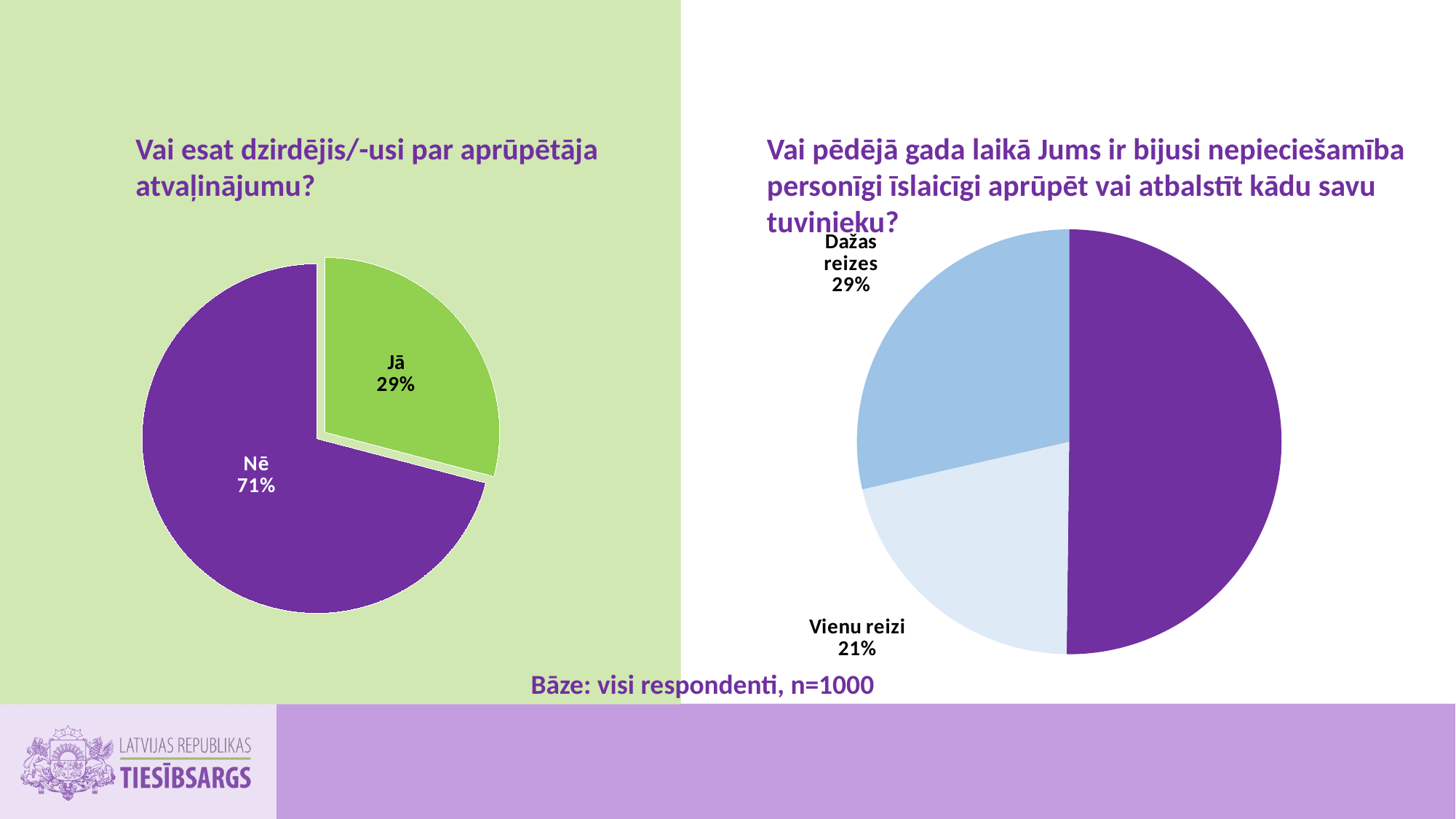
In the left chart ("Vai esat dzirdējis/-usi par aprūpētāja atvaļinājumu?"), what share of respondents answered "Jā"? 29% In the left chart ("Vai esat dzirdējis/-usi par aprūpētāja atvaļinājumu?"), what is the difference in percentage points between "Nē" and "Jā"? 42 percentage points How many slices does the right pie chart ("Vai pēdējā gada laikā Jums ir bijusi nepieciešamība personīgi īslaicīgi aprūpēt vai atbalstīt kādu savu tuvinieku?") have? 3 How many slices does the left pie chart ("Vai esat dzirdējis/-usi par aprūpētāja atvaļinājumu?") have? 2 In the right chart ("Vai pēdējā gada laikā Jums ir bijusi nepieciešamība personīgi īslaicīgi aprūpēt vai atbalstīt kādu savu tuvinieku?"), which is larger: "Dažas reizes" or "Vienu reizi"? Dažas reizes In the left chart ("Vai esat dzirdējis/-usi par aprūpētāja atvaļinājumu?"), which answer has the smallest slice? Jā What colour is the "Jā" slice in the left chart ("Vai esat dzirdējis/-usi par aprūpētāja atvaļinājumu?")? green In the left chart ("Vai esat dzirdējis/-usi par aprūpētāja atvaļinājumu?"), what share of respondents answered "Nē"? 71% In the right chart ("Vai pēdējā gada laikā Jums ir bijusi nepieciešamība personīgi īslaicīgi aprūpēt vai atbalstīt kādu savu tuvinieku?"), what share of respondents answered "Vienu reizi"? 21% In the right chart ("Vai pēdējā gada laikā Jums ir bijusi nepieciešamība personīgi īslaicīgi aprūpēt vai atbalstīt kādu savu tuvinieku?"), what share of respondents answered "Dažas reizes"? 29% In the left chart ("Vai esat dzirdējis/-usi par aprūpētāja atvaļinājumu?"), which answer has the largest slice? Nē What kind of chart is the left chart titled "Vai esat dzirdējis/-usi par aprūpētāja atvaļinājumu?"? pie chart